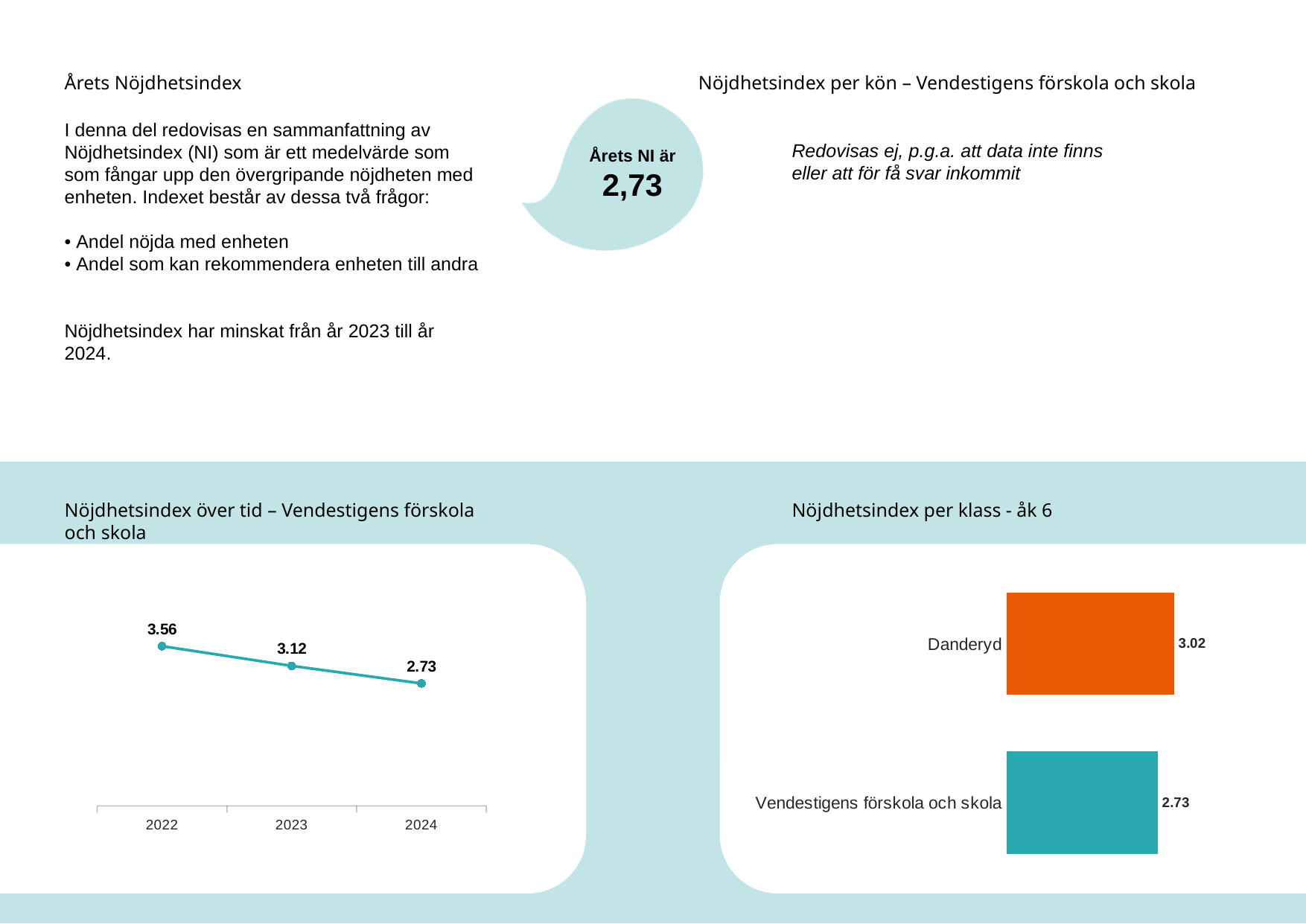
In the 'Nöjdhetsindex över tid – Vendestigens förskola och skola' chart, how many years are plotted? 3 In the 'Nöjdhetsindex över tid – Vendestigens förskola och skola' chart, do the values rise or fall from 2022 to 2024? fall In the 'Nöjdhetsindex över tid – Vendestigens förskola och skola' chart, which year has the highest value? 2022 In the 'Nöjdhetsindex över tid – Vendestigens förskola och skola' chart, what is the value for 2022? 3.56 In the 'Nöjdhetsindex över tid – Vendestigens förskola och skola' chart, what is the value for 2024? 2.73 In the 'Nöjdhetsindex per klass - åk 6' chart, which is larger, Danderyd or Vendestigens förskola och skola? Danderyd In the 'Nöjdhetsindex per klass - åk 6' chart, what is the value for Danderyd? 3.02 In the 'Nöjdhetsindex över tid – Vendestigens förskola och skola' chart, which year has the lowest value? 2024 In the 'Nöjdhetsindex över tid – Vendestigens förskola och skola' chart, what is the value for 2023? 3.12 What kind of chart is the 'Nöjdhetsindex över tid – Vendestigens förskola och skola' chart? line chart What kind of chart is the 'Nöjdhetsindex per klass - åk 6' chart? bar chart In the 'Nöjdhetsindex över tid – Vendestigens förskola och skola' chart, what is the difference between the 2022 and 2024 values? 0.83